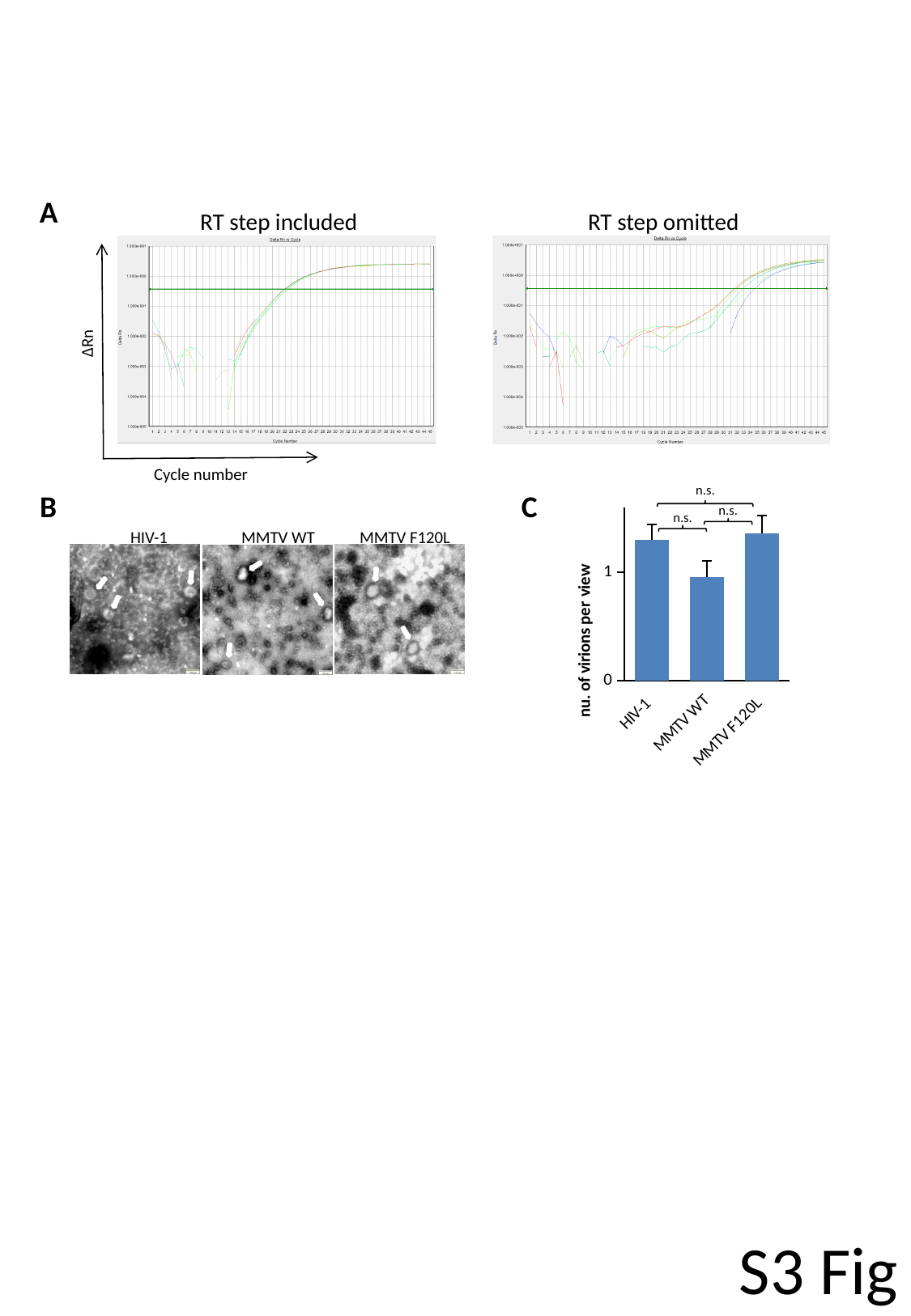
How many categories are shown in the bar chart in panel C? 3 In the 'RT step omitted' chart in panel A, do the curves rise or fall at higher cycle numbers? rise What is the y-axis title of the bar chart in panel C? nu. of virions per view In the bar chart in panel C, which category has the lowest value? MMTV WT What label is shown on the significance brackets above the bars in panel C? n.s. In the bar chart in panel C, is the value for MMTV F120L greater or less than 1? greater What is the x-axis label of the charts in panel A? Cycle number In the bar chart in panel C, is the value for HIV-1 greater or less than 1? greater What kind of chart is panel C? bar chart In the bar chart in panel C, which is larger, the value for HIV-1 or the value for MMTV WT? HIV-1 In the bar chart in panel C, which is larger, the value for MMTV F120L or the value for MMTV WT? MMTV F120L What kind of chart is the 'RT step included' chart in panel A? line chart